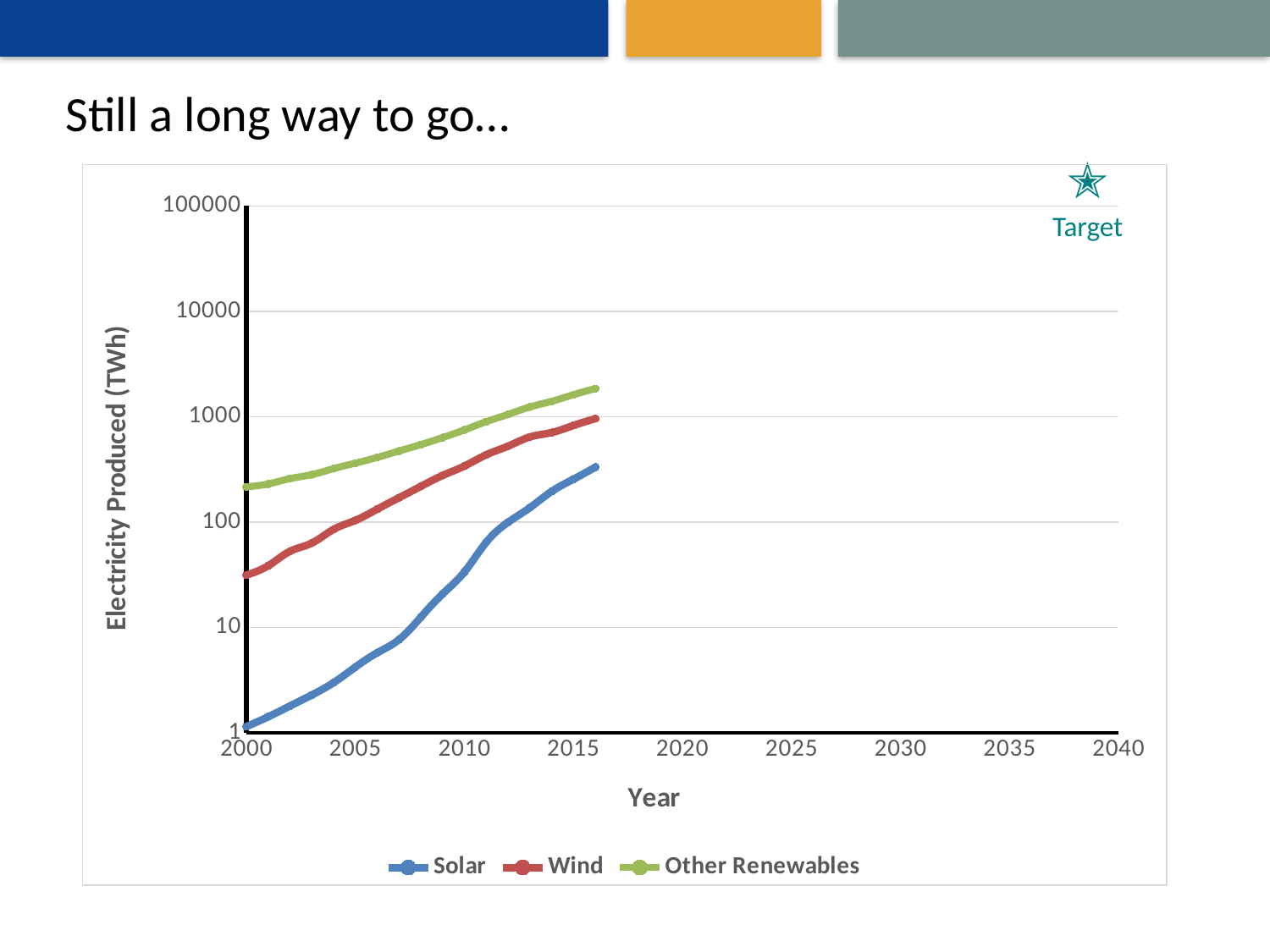
Does the Solar series rise or fall from 2000 to 2016? rise Is the value for Solar in 2010 greater or less than 10? greater Which series has the lowest value in 2016? Solar Is the value for Solar in 2016 greater or less than 1000? less Which is larger in 2016, the value for Wind or the value for Solar? Wind Which series has the highest value in 2016? Other Renewables Is the value for Other Renewables in 2016 greater or less than 1000? greater What label is shown next to the star marker in the top right of the chart? Target How many series does the legend list? 3 What is the label of the y axis? Electricity Produced (TWh) What kind of chart is shown on the slide? line chart